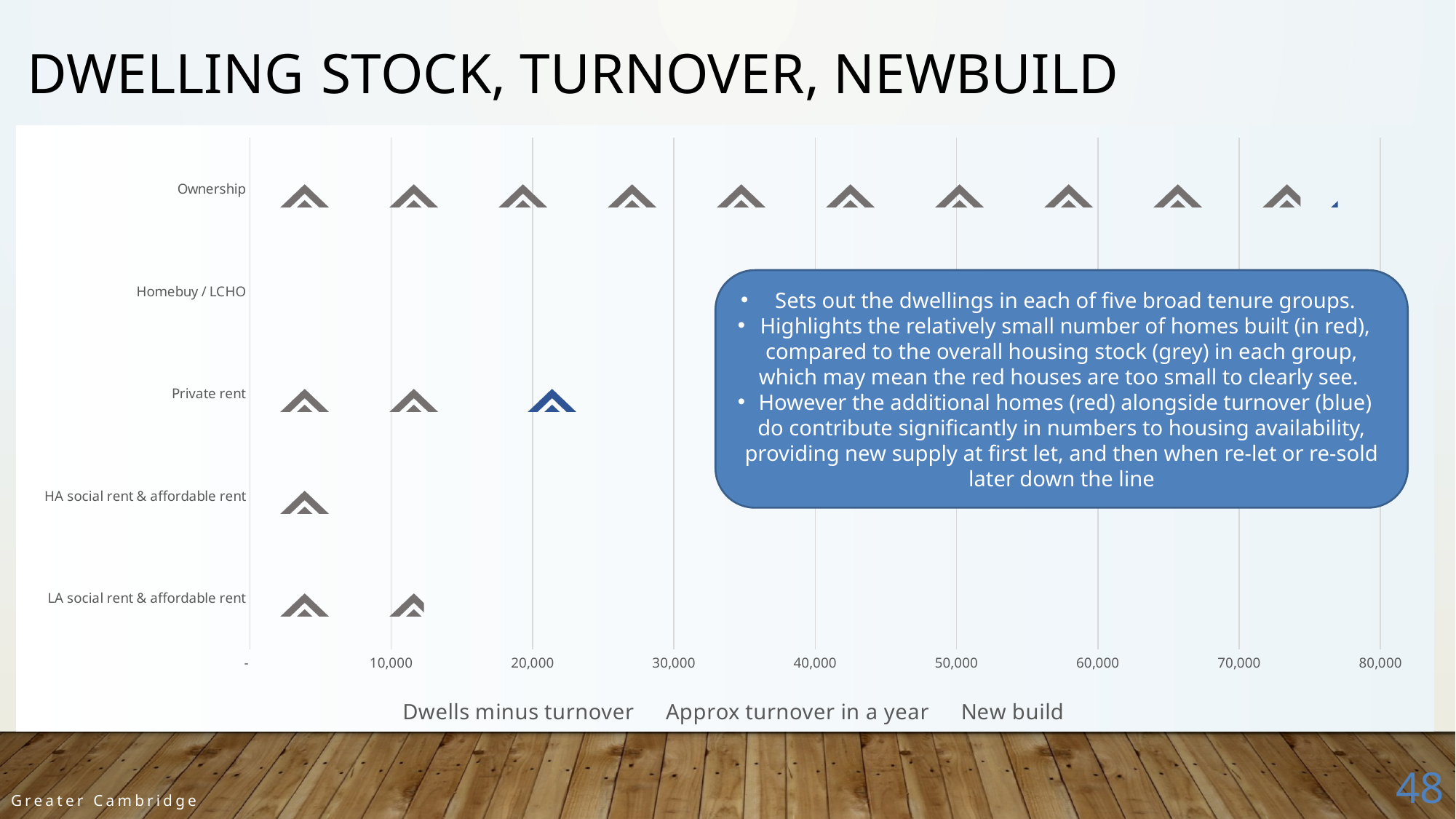
Which tenure category shows the smallest (essentially no visible) dwelling stock in the chart? Homebuy / LCHO How many tenure categories are shown on the y axis of the chart? 5 Which tenure category has the largest total dwelling stock in the chart? Ownership What is the title of the slide containing the chart? DWELLING STOCK, TURNOVER, NEWBUILD What are the three legend entries of the chart? Dwells minus turnover, Approx turnover in a year, New build Is the total value for Private rent greater or less than 30,000? less Which is larger, the total for Ownership or the total for Private rent? Ownership How many series does the chart legend list? 3 Is the total value for LA social rent & affordable rent greater or less than 10,000? greater Which is larger, the total for Private rent or the total for LA social rent & affordable rent? Private rent Is the total value for HA social rent & affordable rent greater or less than 10,000? less